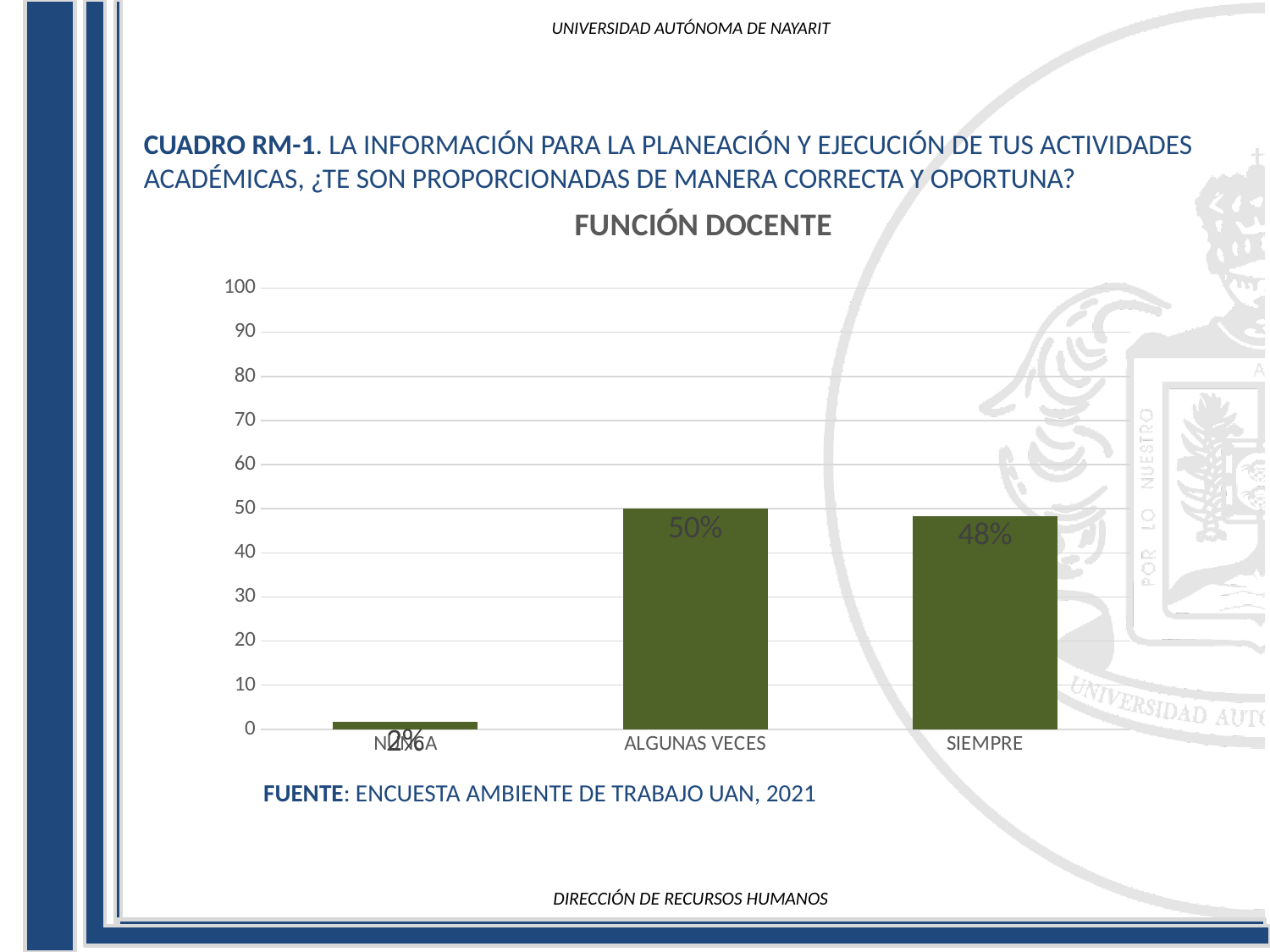
How many categories are shown on the x axis of the chart? 3 Which is larger, the value for SIEMPRE or the value for NUNCA? SIEMPRE What is the value for SIEMPRE? 48% Which category has the lowest value? NUNCA Which category has the highest value? ALGUNAS VECES What is the difference between the values for ALGUNAS VECES and SIEMPRE? 2% What kind of chart is shown under the title FUNCIÓN DOCENTE? bar chart What is the value for ALGUNAS VECES? 50% What is the value for NUNCA? 2% Is the value for SIEMPRE greater or less than 40? greater What is the difference between the values for SIEMPRE and NUNCA? 46% What is the title of the chart? FUNCIÓN DOCENTE